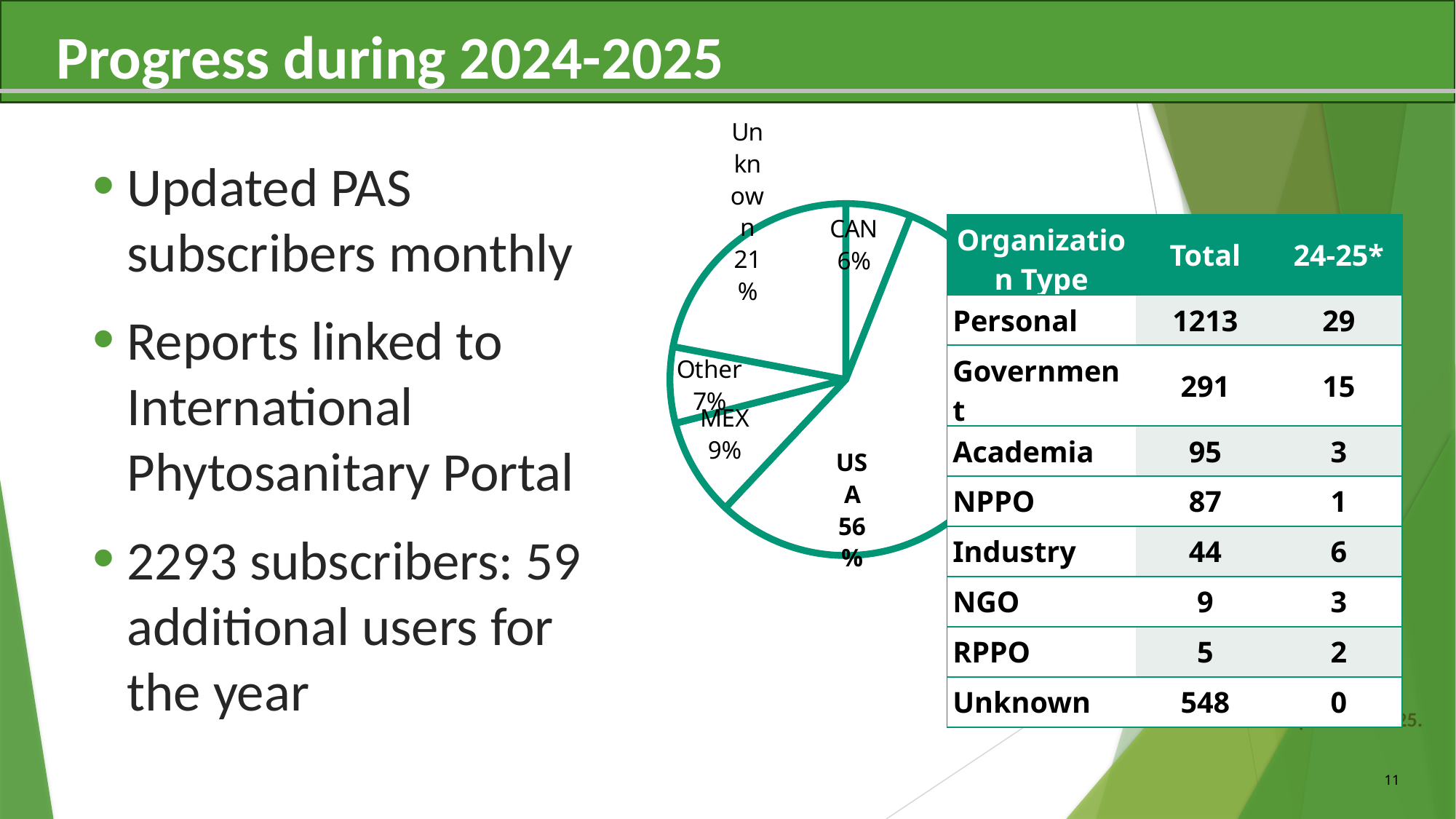
Which slice is larger in the pie chart, MEX or Other? MEX What percentage is shown for the Other slice of the pie chart? 7% What percentage is shown for MEX in the pie chart? 9% What percentage is shown for the Unknown slice of the pie chart? 21% By how many percentage points does the MEX slice exceed the CAN slice in the pie chart? 3 How many slices does the pie chart have? 5 Which slice of the pie chart is the largest? USA What kind of chart is shown on the slide? pie chart What share of the pie chart does USA account for? 56% Which slice of the pie chart is the smallest? CAN What percentage is shown for CAN in the pie chart? 6% By how many percentage points does the USA slice exceed the Unknown slice in the pie chart? 35